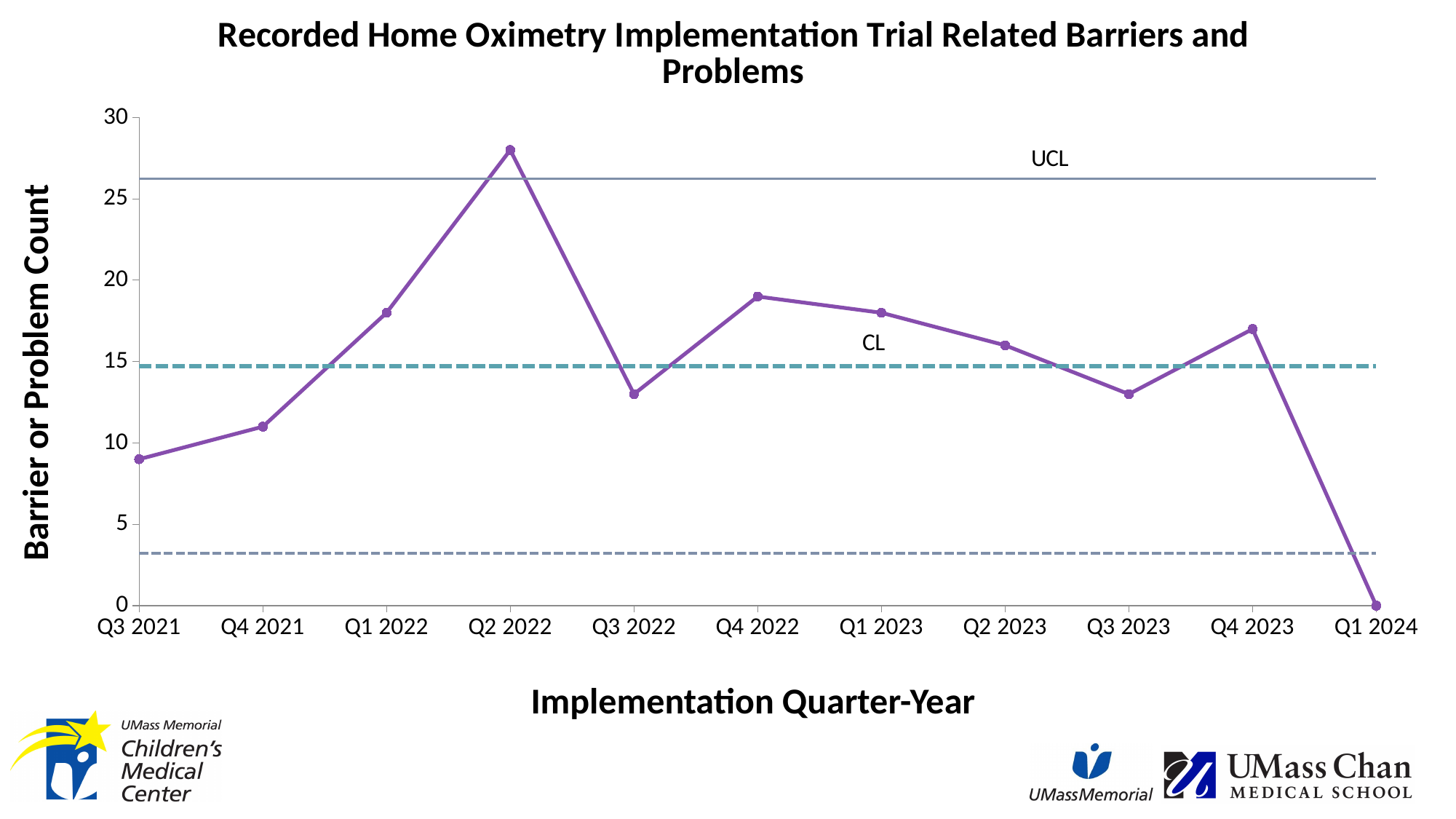
Is the value for Q2 2022 greater or less than 25? greater What kind of chart is shown on the slide? line chart What is the label of the y axis? Barrier or Problem Count Which quarter-year has the highest barrier or problem count? Q2 2022 Which quarter-year has the lowest barrier or problem count? Q1 2024 Do the values rise or fall from Q4 2022 to Q3 2023? fall Which has the larger barrier or problem count, Q2 2022 or Q3 2022? Q2 2022 What is the barrier or problem count for Q1 2024? 0 What is the title of the chart? Recorded Home Oximetry Implementation Trial Related Barriers and Problems How many quarter-year points are plotted on the chart? 11 Is the value for Q3 2022 greater or less than 15? less Is the value for Q3 2021 greater or less than 10? less